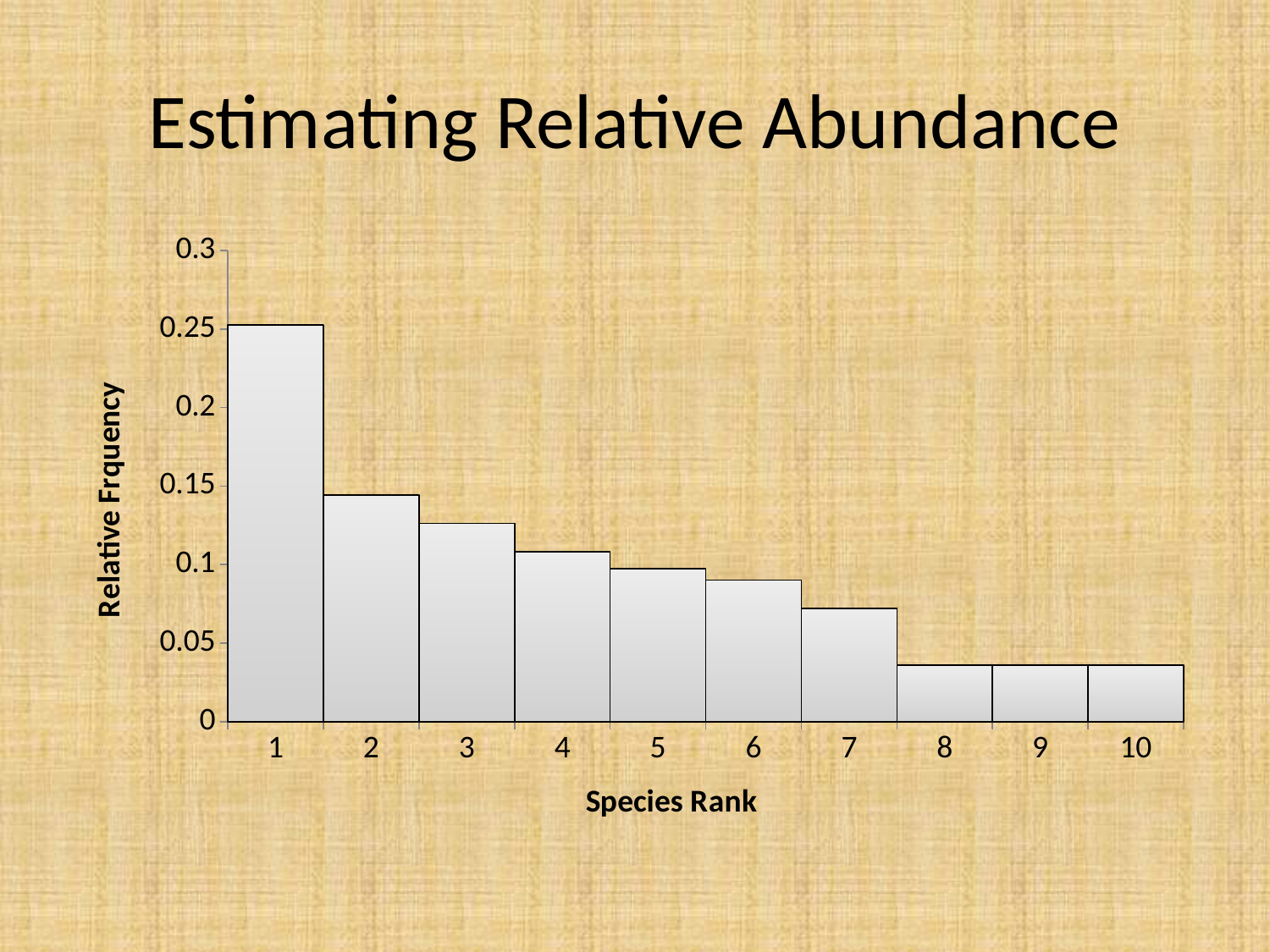
Is the relative frequency for species rank 1 greater or less than 0.2? greater Is the relative frequency for species rank 6 greater or less than 0.1? less Is the relative frequency for species rank 8 greater or less than 0.05? less Which species rank has the highest relative frequency? 1 How many species ranks are plotted on the x axis? 10 Which has a higher relative frequency, species rank 2 or species rank 7? species rank 2 Do the relative frequency values rise or fall as species rank increases from 1 to 10? fall What is the label on the x axis of the chart? Species Rank What kind of chart is shown on the slide? bar chart What is the label on the y axis of the chart? Relative Frquency